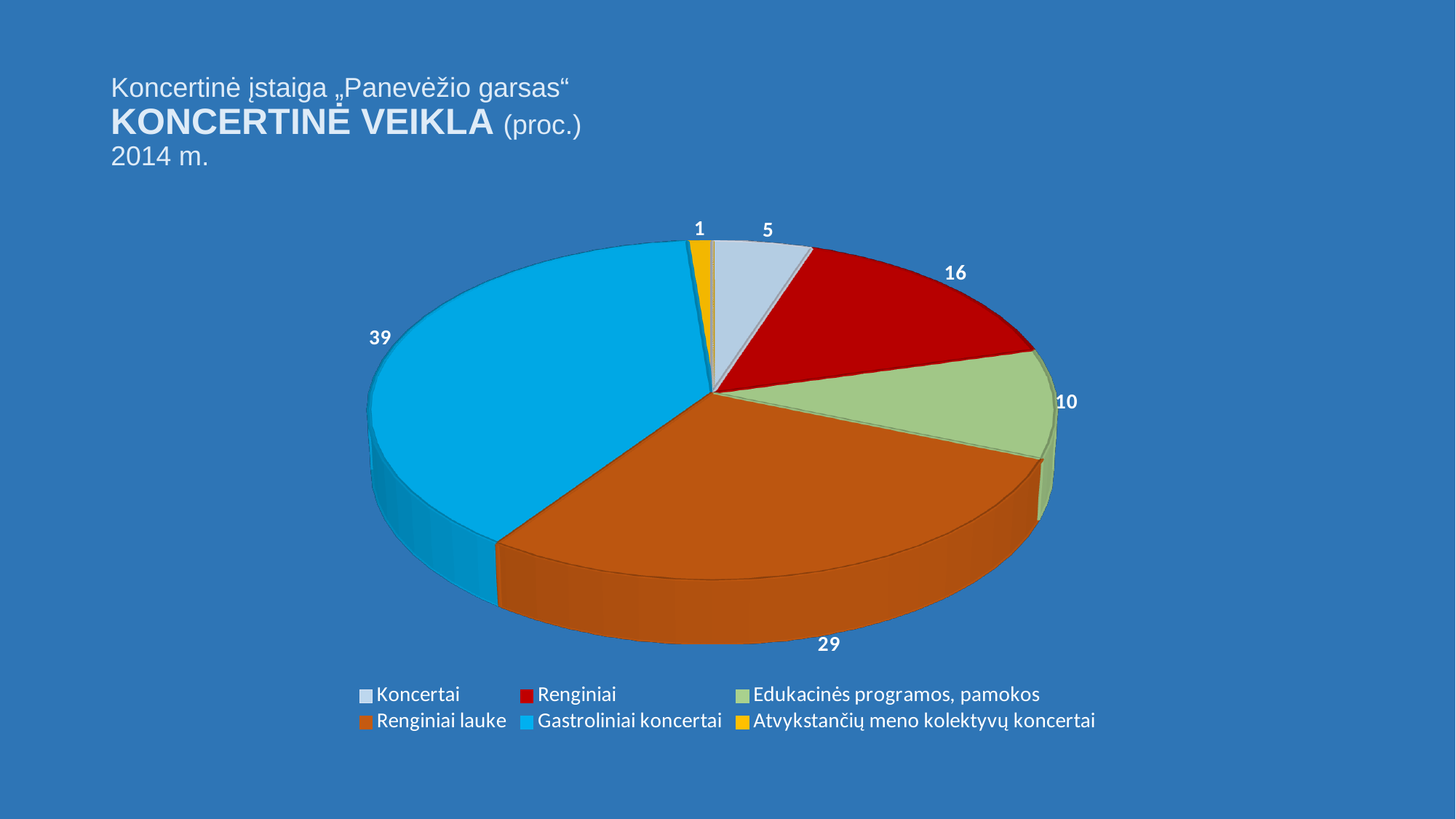
Which is larger, the value for Renginiai or the value for Edukacinės programos, pamokos? Renginiai What is the value for Koncertai? 5 What is the value for Renginiai lauke? 29 What is the value for Edukacinės programos, pamokos? 10 What is the value for Gastroliniai koncertai? 39 What is the value for Renginiai? 16 Which year does the chart title refer to? 2014 m. Which category has the smallest slice of the pie? Atvykstančių meno kolektyvų koncertai How many categories does the legend list? 6 What kind of chart is shown on the slide? pie chart Which category has the largest slice of the pie? Gastroliniai koncertai What is the difference between the values for Gastroliniai koncertai and Renginiai lauke? 10